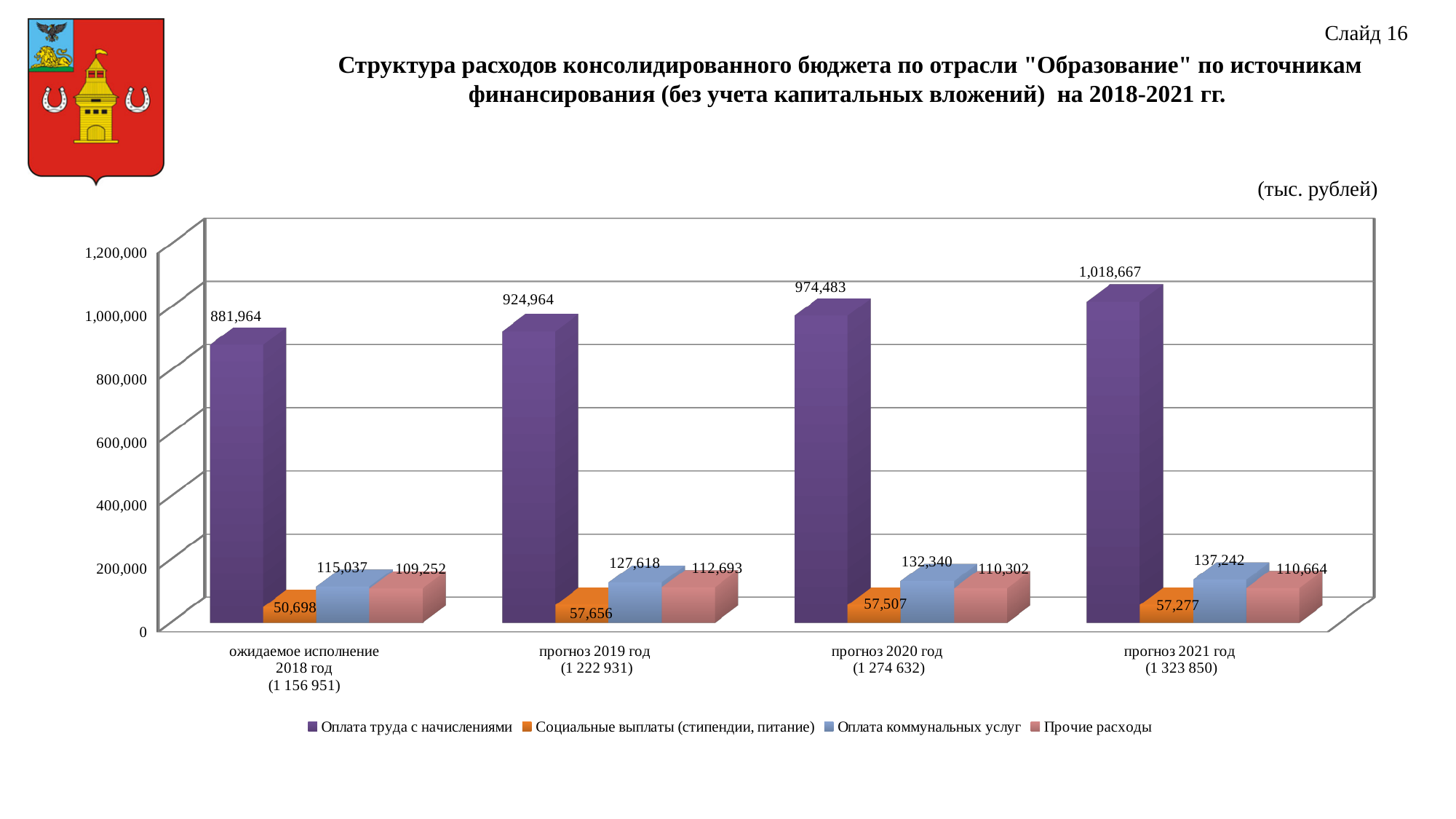
How many series does the legend list? 4 What is the value of Прочие расходы for прогноз 2019 год? 112,693 In which category is Оплата труда с начислениями the highest? прогноз 2021 год What kind of chart is shown on the slide? bar chart Which is larger for прогноз 2020 год: Оплата коммунальных услуг or Прочие расходы? Оплата коммунальных услуг In which category is Оплата коммунальных услуг the lowest? ожидаемое исполнение 2018 год What is the value of Оплата труда с начислениями for прогноз 2021 год? 1,018,667 What is the value of Оплата коммунальных услуг for прогноз 2020 год? 132,340 How many categories are shown on the x axis? 4 Does Оплата труда с начислениями rise or fall from 2018 to 2021? rise What is the difference between Оплата труда с начислениями for прогноз 2021 год and for ожидаемое исполнение 2018 год? 136,703 What is the value of Социальные выплаты (стипендии, питание) for ожидаемое исполнение 2018 год? 50,698